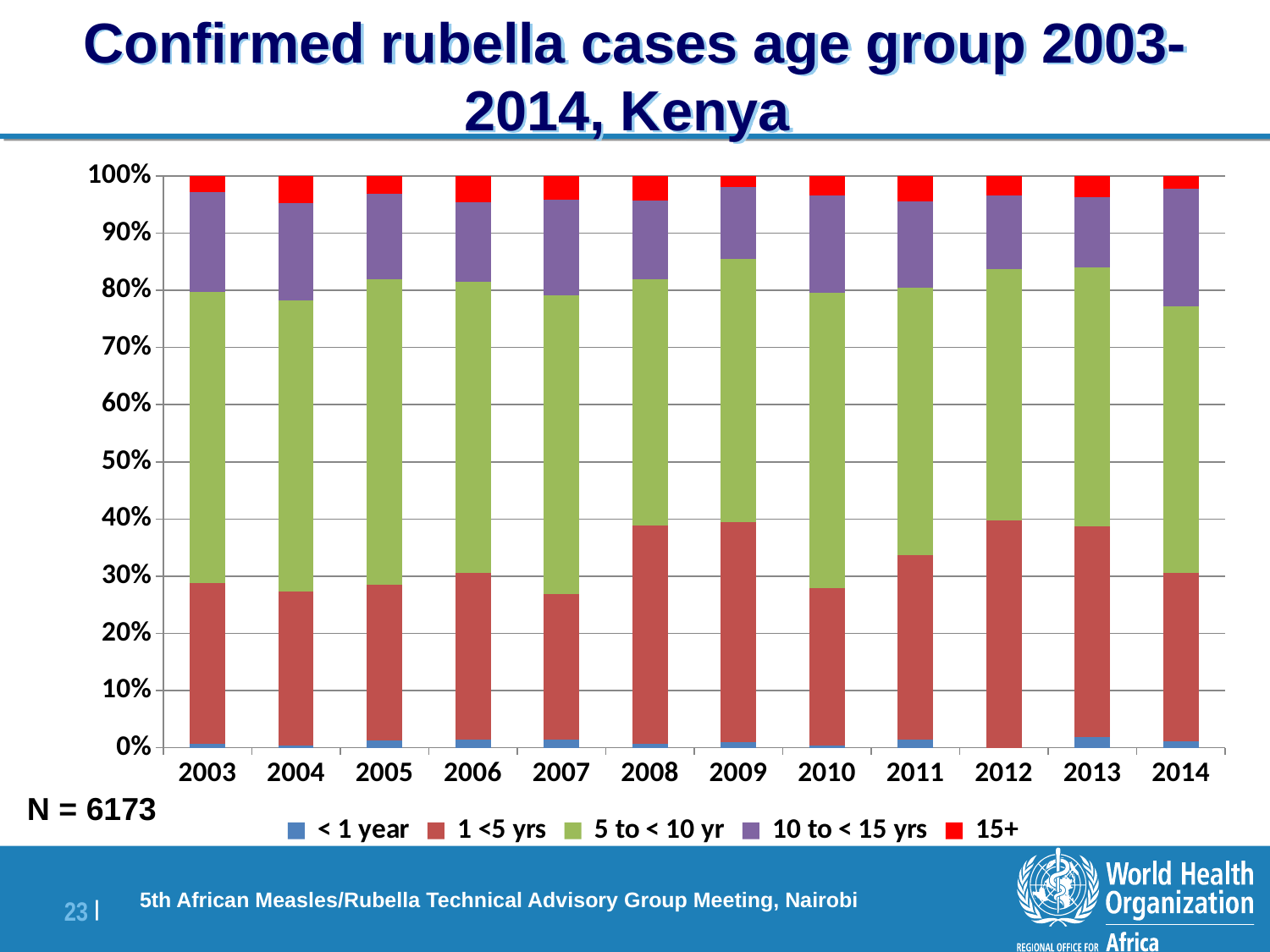
How many years are shown along the x axis of the chart? 12 What kind of chart is shown on the slide? Stacked bar chart Is the cumulative share of cases under 10 years (top of the 5 to < 10 yr segment) in 2014 greater or less than 80%? less What is the total height of each stacked bar in the chart? 100% Which colour represents the 15+ age group in the legend? Red Which year has the largest share of cases in the 10 to < 15 yrs age group? 2014 Is the share of the 1 <5 yrs age group in 2007 greater or less than 30%? less How many age-group series does the legend list? 5 What is the title of the chart? Confirmed rubella cases age group 2003-2014, Kenya Is the share of the 1 <5 yrs age group larger in 2007 or in 2008? 2008 Is the cumulative share of cases under 10 years (top of the 5 to < 10 yr segment) in 2009 greater or less than 80%? greater